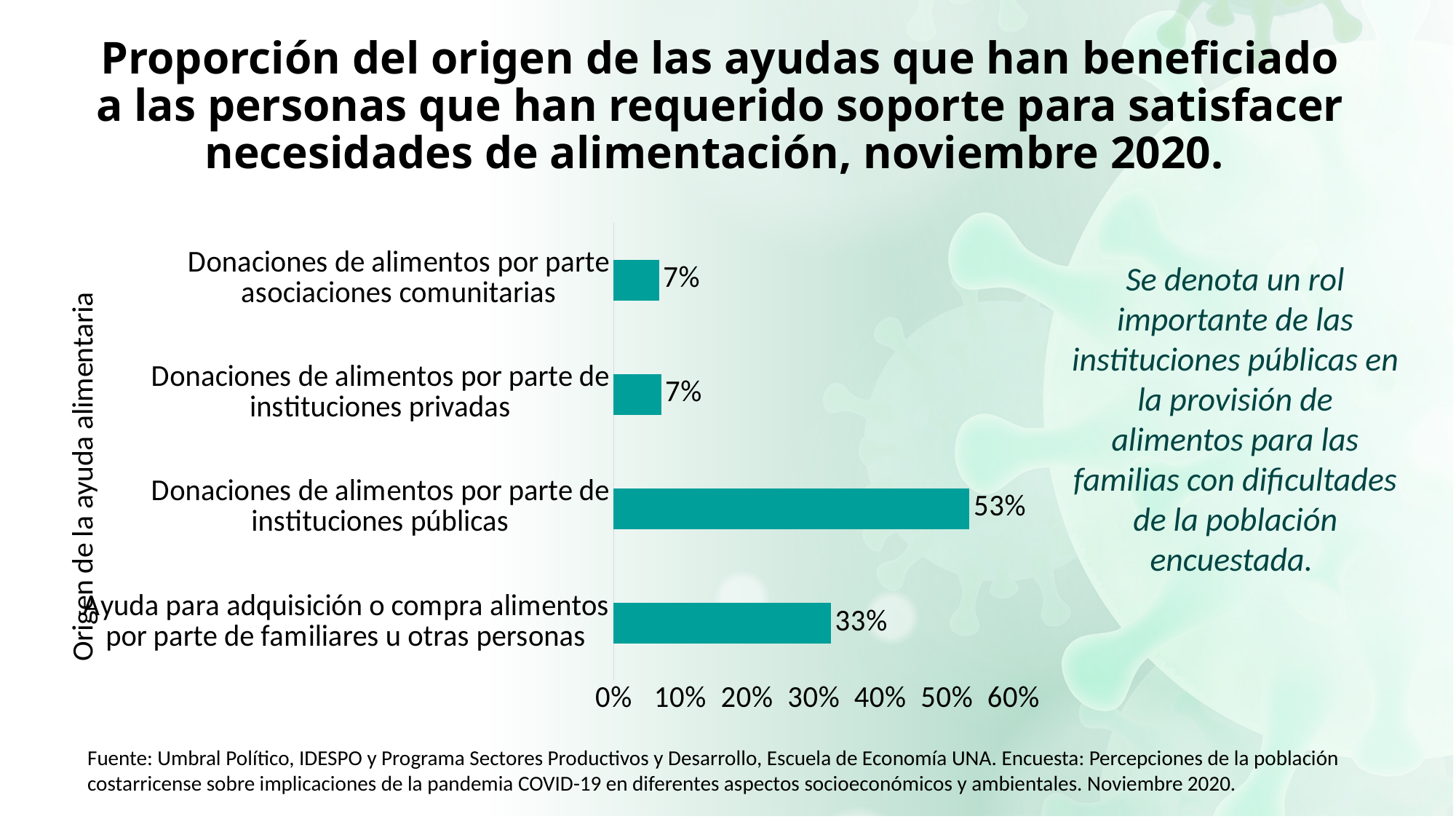
What is the label of the vertical axis of the chart? Origen de la ayuda alimentaria What kind of chart is shown on the slide? Bar chart What is the difference between the values for 'Ayuda para adquisición o compra alimentos por parte de familiares u otras personas' and 'Donaciones de alimentos por parte de instituciones privadas'? 26% Which is larger: the value for 'Donaciones de alimentos por parte de instituciones públicas' or the value for 'Ayuda para adquisición o compra alimentos por parte de familiares u otras personas'? Donaciones de alimentos por parte de instituciones públicas What is the value for 'Donaciones de alimentos por parte asociaciones comunitarias'? 7% What is the value for 'Ayuda para adquisición o compra alimentos por parte de familiares u otras personas'? 33% Which category has the highest value? Donaciones de alimentos por parte de instituciones públicas Is the value for 'Donaciones de alimentos por parte de instituciones públicas' greater or less than 50%? greater What is the value for 'Donaciones de alimentos por parte de instituciones públicas'? 53% How many categories are shown in the chart? 4 What is the value for 'Donaciones de alimentos por parte de instituciones privadas'? 7% What is the difference between the values for 'Donaciones de alimentos por parte de instituciones públicas' and 'Ayuda para adquisición o compra alimentos por parte de familiares u otras personas'? 20%